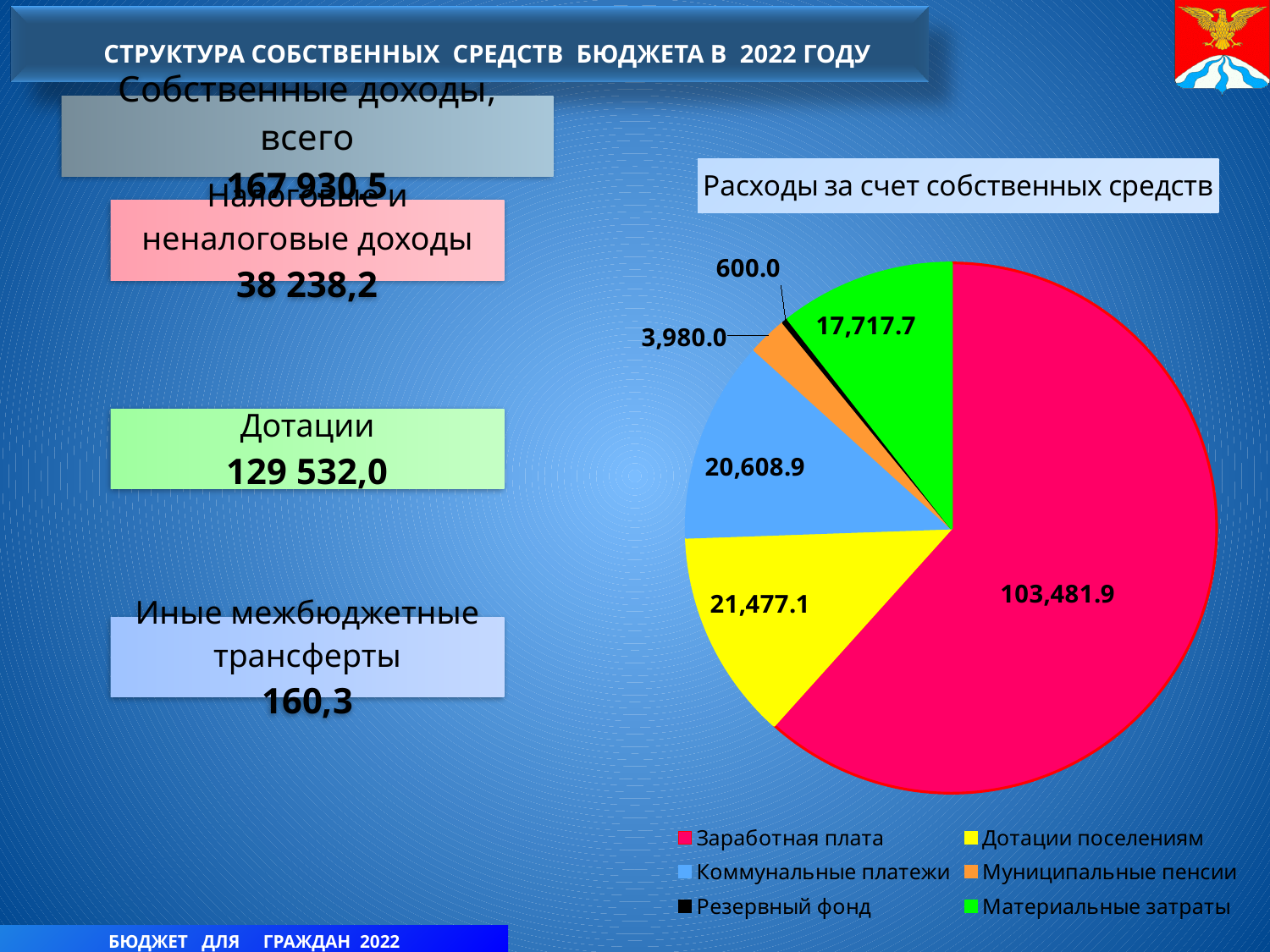
What is the title of the pie chart? Расходы за счет собственных средств What is the value for Заработная плата in the pie chart? 103,481.9 How many slices does the pie chart have? 6 Which category has the largest slice in the pie chart? Заработная плата Which category has the smallest slice in the pie chart? Резервный фонд What is the difference between Дотации поселениям and Коммунальные платежи in the pie chart? 868.2 What is the value for Материальные затраты in the pie chart? 17,717.7 What is the value for Резервный фонд in the pie chart? 600.0 How many entries does the legend of the pie chart list? 6 What kind of chart is shown on the slide? pie chart Which is larger in the pie chart: Дотации поселениям or Коммунальные платежи? Дотации поселениям What is the value for Коммунальные платежи in the pie chart? 20,608.9